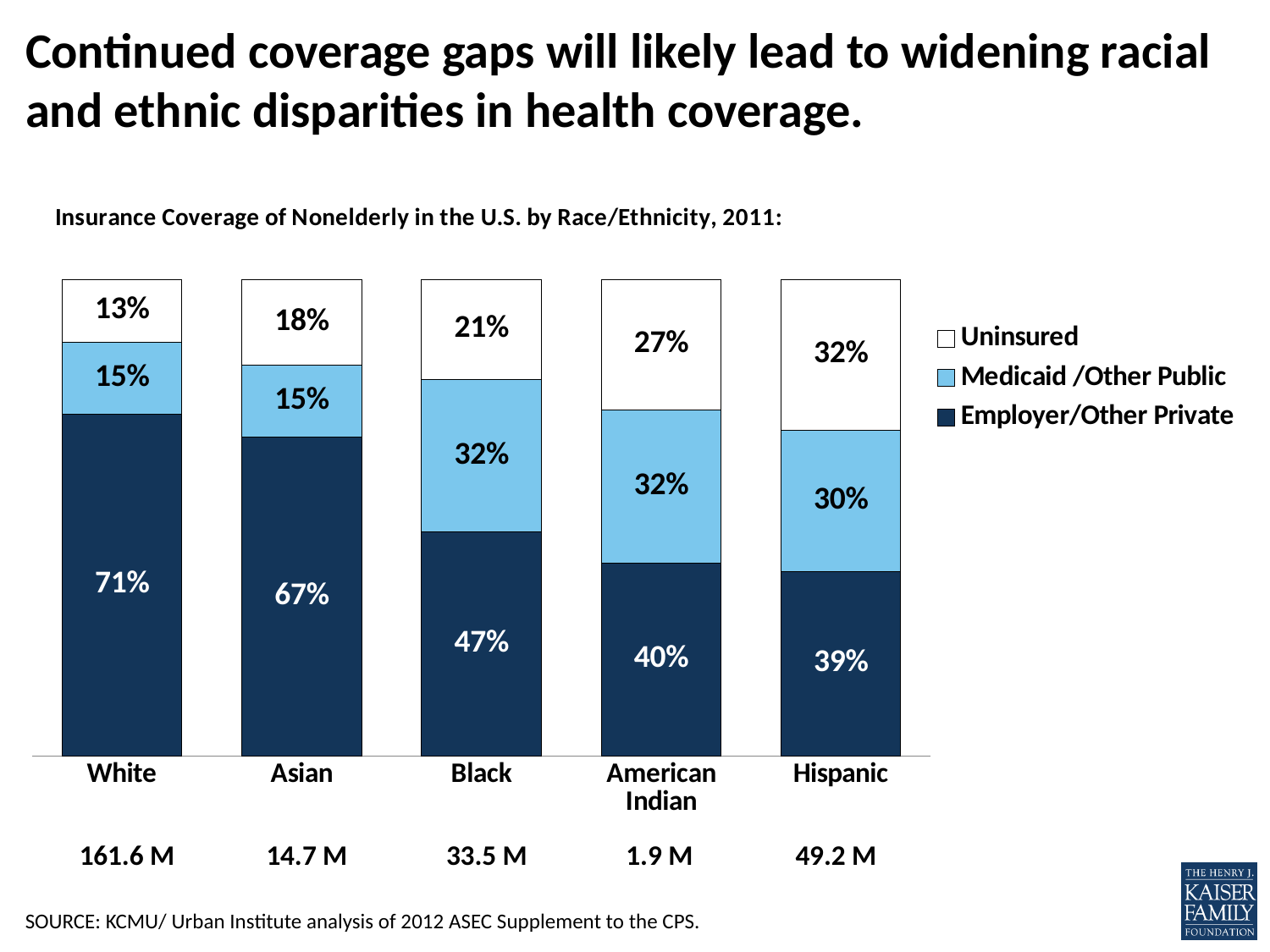
Which race/ethnicity has the highest Uninsured share? Hispanic Does the Uninsured share rise or fall moving from White to Hispanic along the x axis? Rise What is the Employer/Other Private share for White? 71% What is the Uninsured share for Hispanic? 32% How many series does the legend list? 3 What population figure is shown beneath the Black bar? 33.5 M Which is larger, the Uninsured share for Asian or for Black? Black Which race/ethnicity has the lowest Employer/Other Private share? Hispanic What kind of chart is shown on the slide? Stacked bar chart How many race/ethnicity categories are shown on the chart? 5 What is the Medicaid /Other Public share for Black? 32% What is the difference between the Employer/Other Private shares for White and Hispanic? 32%